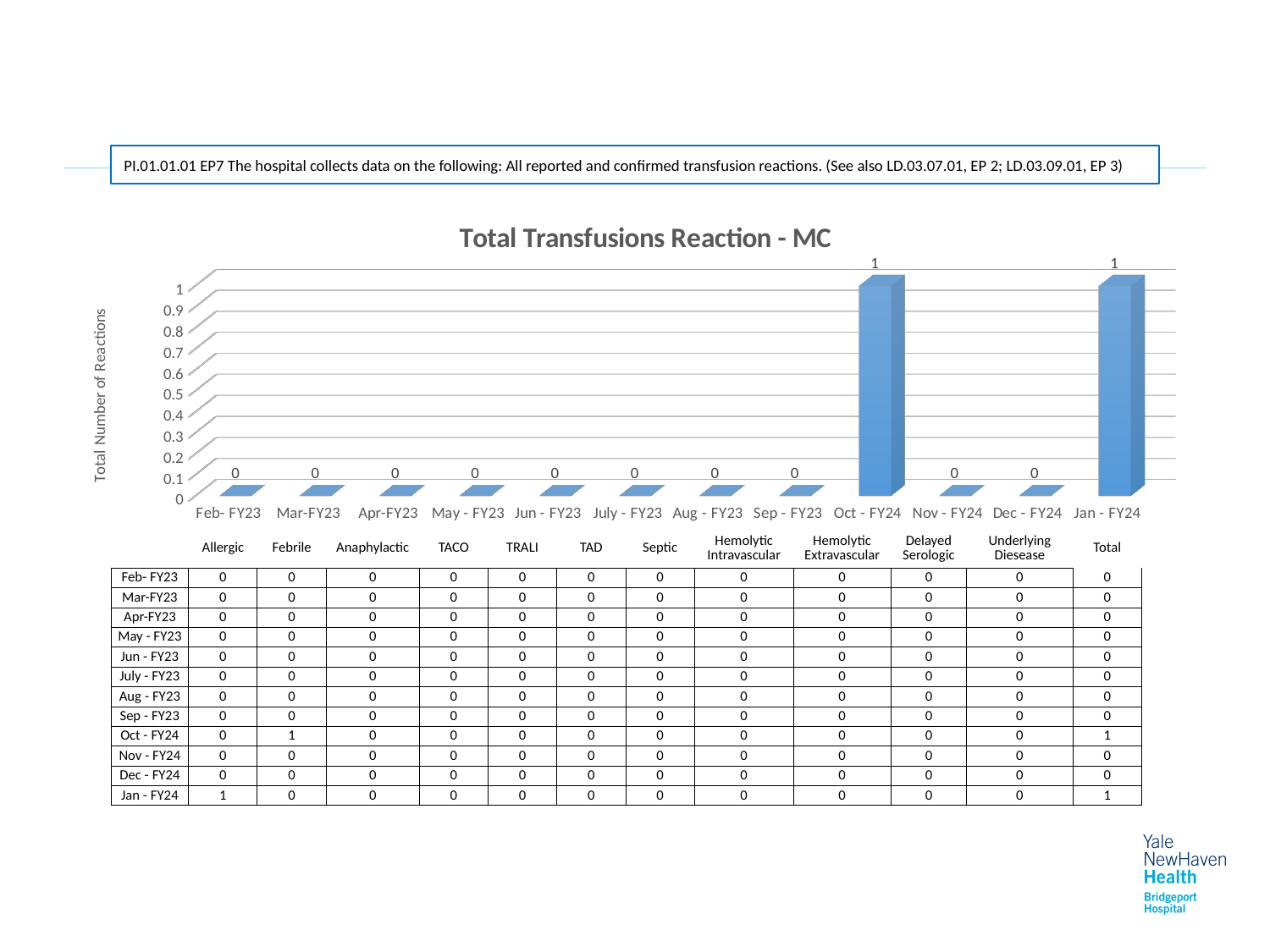
What is the difference between the value for Jan - FY24 and the value for Dec - FY24? 1 Which month has the lowest value in the chart, Oct - FY24 or Mar-FY23? Mar-FY23 How many months in the chart have a value of 0? 10 What is the value for Sep - FY23 in the chart? 0 What is the value for Jan - FY24 in the chart? 1 What is the value for Oct - FY24 in the chart? 1 What is the label on the vertical axis of the chart? Total Number of Reactions How many months are plotted along the x axis of the chart? 12 What kind of chart is shown on the slide? bar chart Which is larger in the chart, the value for Oct - FY24 or the value for Dec - FY24? Oct - FY24 What is the value for Nov - FY24 in the chart? 0 What is the title of the chart? Total Transfusions Reaction - MC